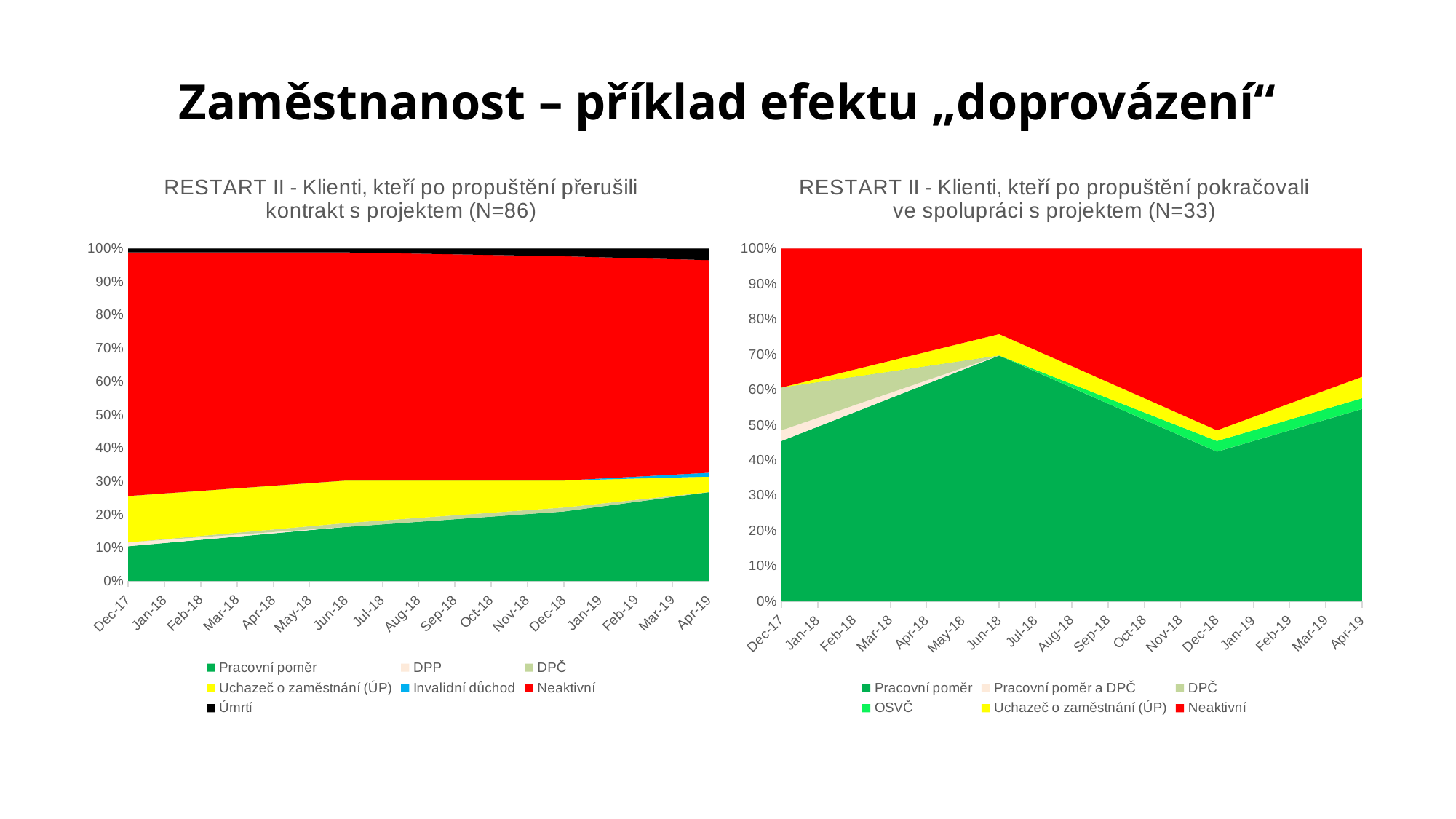
In the left chart (N=86), is the value for "Pracovní poměr" at Apr-19 greater or less than 20%? greater Which series is shown in red in both charts? Neaktivní In the left chart (N=86), does the share of "Pracovní poměr" rise or fall from Dec-17 to Apr-19? Rise In the right chart (N=33), is the share of "Pracovní poměr" larger at Jun-18 or at Dec-18? Jun-18 How many series does the legend of the left chart (N=86) list? 7 How many months are shown on the x axis of the right chart (N=33)? 17 In the right chart (N=33), in which month does the share of "Pracovní poměr" reach its highest point? Jun-18 What kind of chart is the left chart titled "RESTART II - Klienti, kteří po propuštění přerušili kontrakt s projektem (N=86)"? Stacked area chart In the right chart (N=33), is the value for "Pracovní poměr" at Jun-18 greater or less than 60%? greater In the right chart (N=33), in which month is the share of "Pracovní poměr" lowest? Dec-18 In the left chart (N=86), is the value for "Pracovní poměr" at Dec-17 greater or less than 20%? less How many series does the legend of the right chart (N=33) list? 6